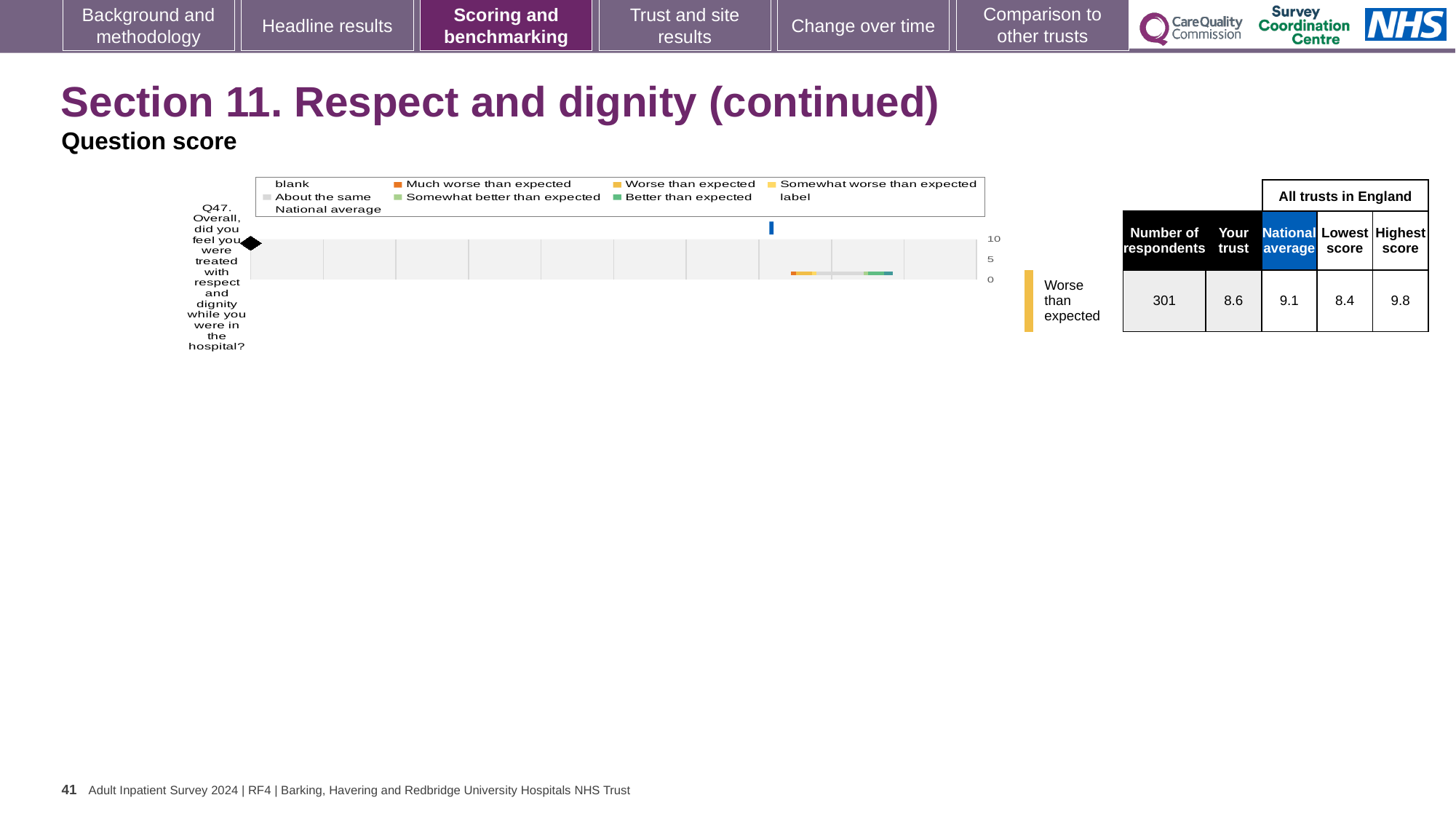
What is the national average score for Q47 shown in the table? 9.1 Which is larger for Q47: the 'Your trust' score or the national average? National average How many questions (categories) are plotted on the chart? 1 What is the highest value shown on the chart's axis? 10 How many entries does the chart legend list? 9 What is the difference between the national average and the 'Your trust' score for Q47? 0.5 What is the 'Your trust' score for Q47 shown in the table? 8.6 What benchmarking category is the trust's score for Q47 given on the slide? Worse than expected Which question is plotted on the chart? Q47. Overall, did you feel you were treated with respect and dignity while you were in the hospital? What is the number of respondents for Q47? 301 What kind of chart is shown on the slide? Bar chart What is the difference between the highest score and the lowest score for Q47 across all trusts in England? 1.4